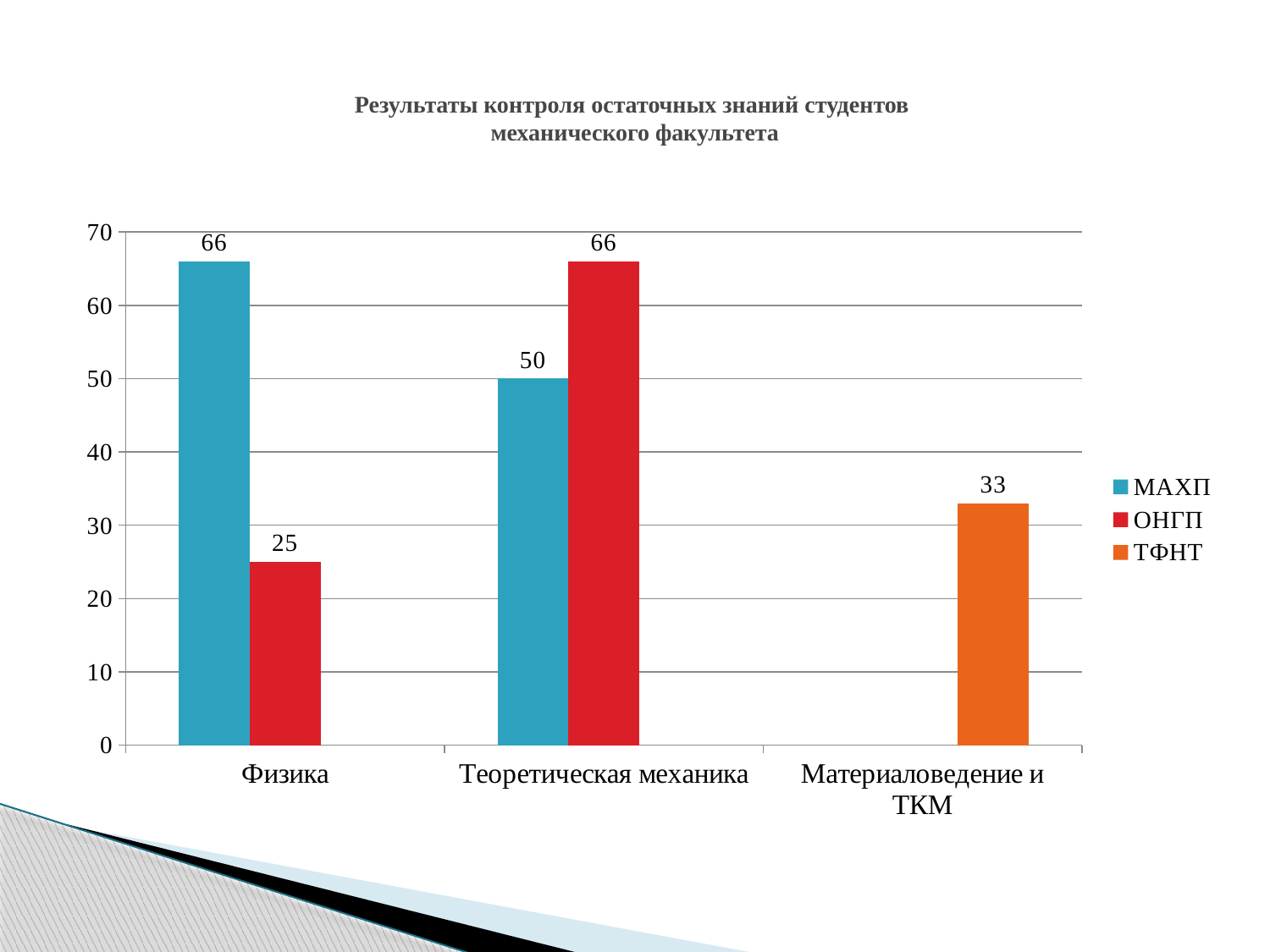
Which is larger in Теоретическая механика: МАХП or ОНГП? ОНГП What is the value for МАХП in Физика? 66 What is the value for ОНГП in Теоретическая механика? 66 What is the value for ОНГП in Физика? 25 What is the value for МАХП in Теоретическая механика? 50 How many series does the legend list? 3 Which series has the highest value in Теоретическая механика? ОНГП What is the value for ТФНТ in Материаловедение и ТКМ? 33 What is the difference between the МАХП and ОНГП values in Физика? 41 Which series has the lowest value in Физика? ОНГП What kind of chart is shown on the slide? Bar chart How many categories are shown on the x axis? 3